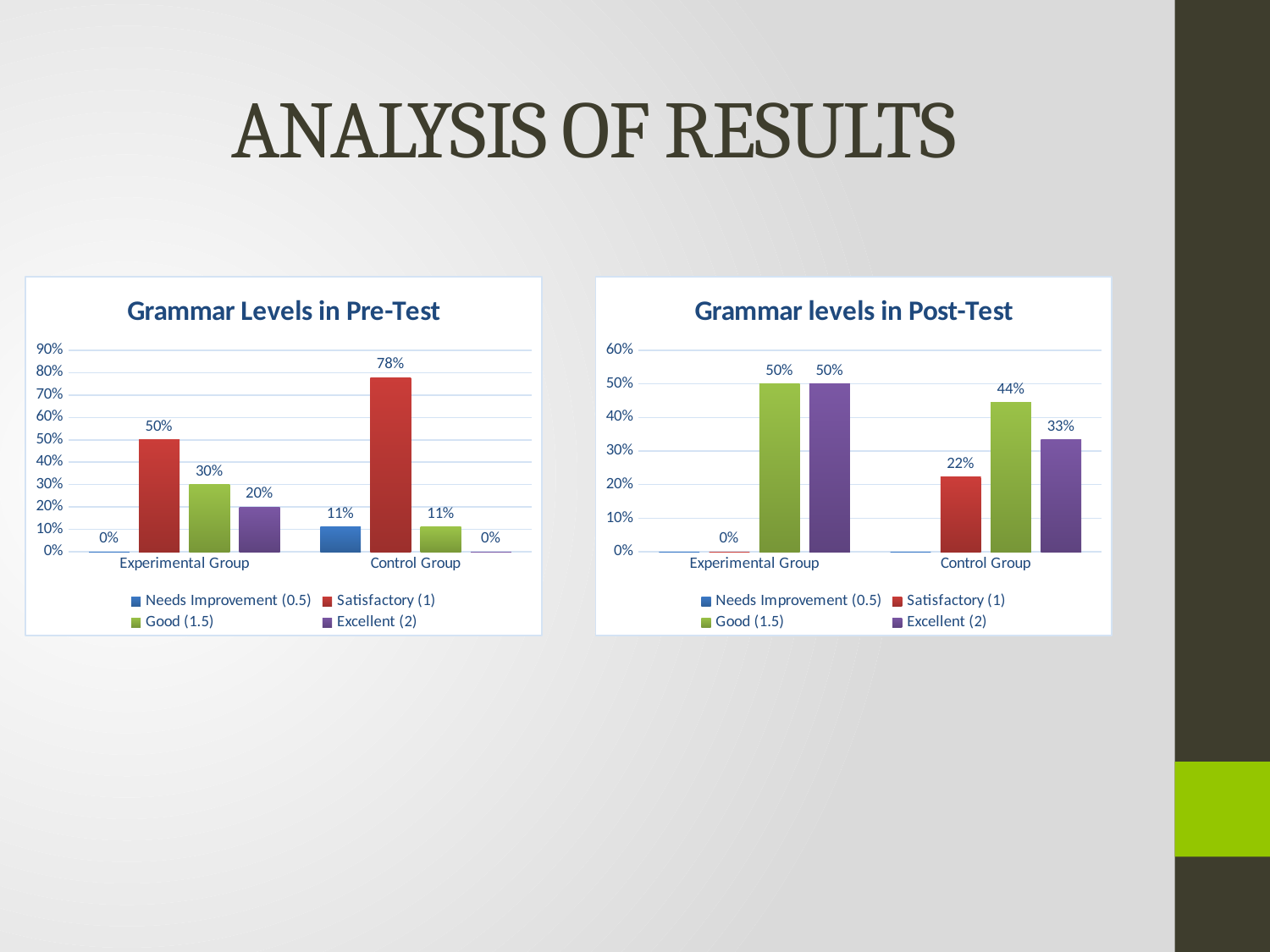
How many series does the legend of the Grammar Levels in Pre-Test chart list? 4 In the Grammar Levels in Pre-Test chart, what is the difference between the Satisfactory (1) values for the Control Group and the Experimental Group? 28 percentage points What kind of chart is the Grammar levels in Post-Test chart? Bar chart In the Grammar Levels in Pre-Test chart, which level has the highest value for the Control Group? Satisfactory (1) In the Grammar Levels in Pre-Test chart, what is the Excellent (2) value for the Experimental Group? 20% In the Grammar levels in Post-Test chart, what is the Satisfactory (1) value for the Experimental Group? 0% In the Grammar levels in Post-Test chart, what is the Good (1.5) value for the Control Group? 44% In the Grammar levels in Post-Test chart, what is the difference between the Good (1.5) and Excellent (2) values for the Control Group? 11 percentage points In the Grammar levels in Post-Test chart, what is the Excellent (2) value for the Control Group? 33% In the Grammar levels in Post-Test chart, which is larger for the Control Group, Good (1.5) or Excellent (2)? Good (1.5) In the Grammar Levels in Pre-Test chart, what is the Good (1.5) value for the Experimental Group? 30% In the Grammar Levels in Pre-Test chart, what is the Satisfactory (1) value for the Control Group? 78%